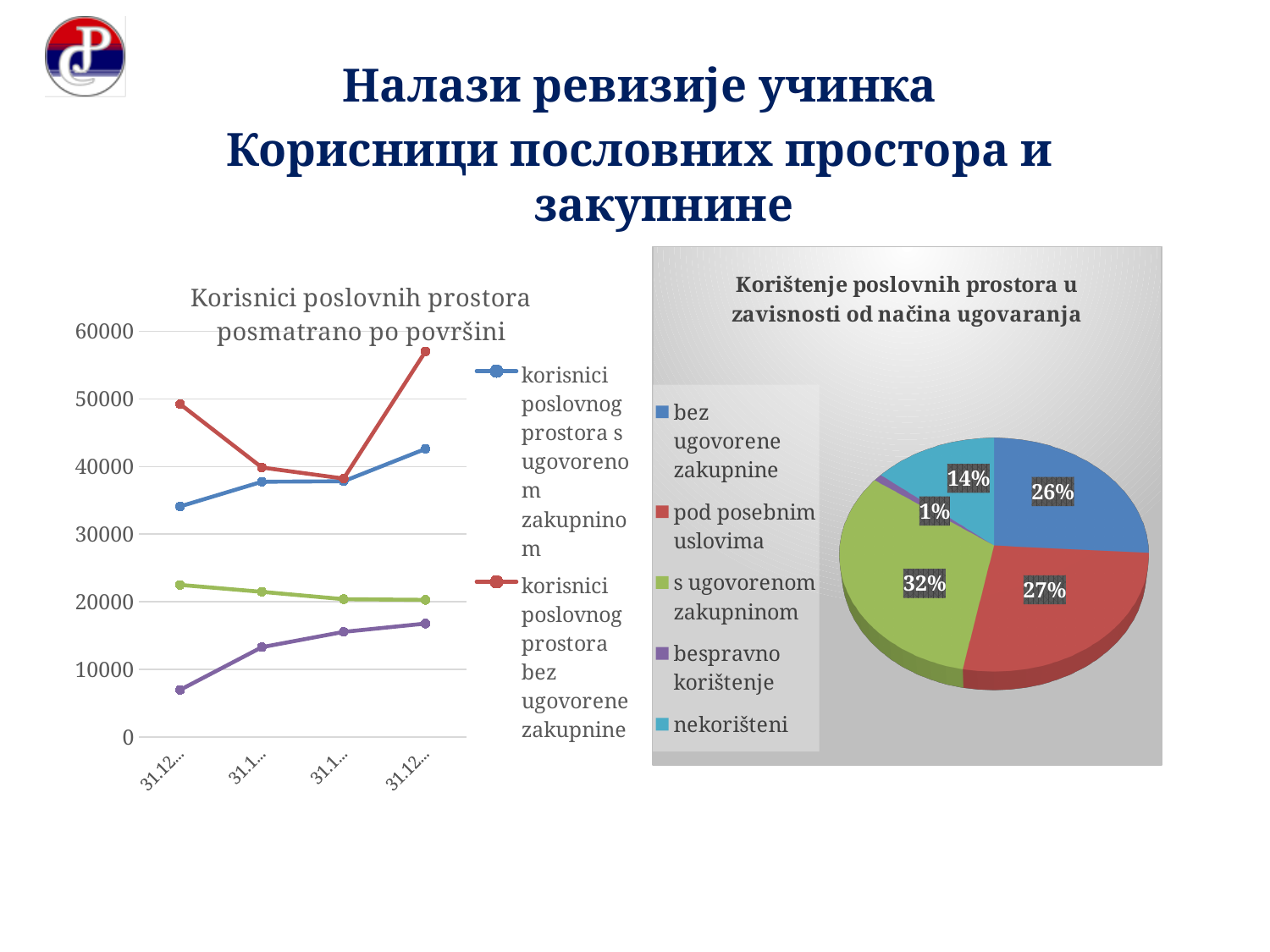
In the pie chart on the right, what percentage is shown for 'pod posebnim uslovima'? 27% In the pie chart on the right, what percentage is shown for 'nekorišteni'? 14% In the line chart on the left, how many lines are plotted? 4 In the pie chart on the right, which category has the smallest share? bespravno korištenje In the line chart on the left, is the first value of the blue line 'korisnici poslovnog prostora s ugovorenom zakupninom' greater or less than 40000? less In the pie chart on the right, how many categories does the legend list? 5 In the line chart on the left, is the last value of the red line 'korisnici poslovnog prostora bez ugovorene zakupnine' greater or less than 50000? greater What type of chart is the chart on the right side of the slide? Pie chart In the pie chart on the right, what is the difference in percentage points between 's ugovorenom zakupninom' and 'bez ugovorene zakupnine'? 6 percentage points In the pie chart 'Korištenje poslovnih prostora u zavisnosti od načina ugovaranja', what share is labelled for 's ugovorenom zakupninom'? 32% In the pie chart on the right, which category has the largest share? s ugovorenom zakupninom What type of chart is 'Korisnici poslovnih prostora posmatrano po površini' on the left? Line chart